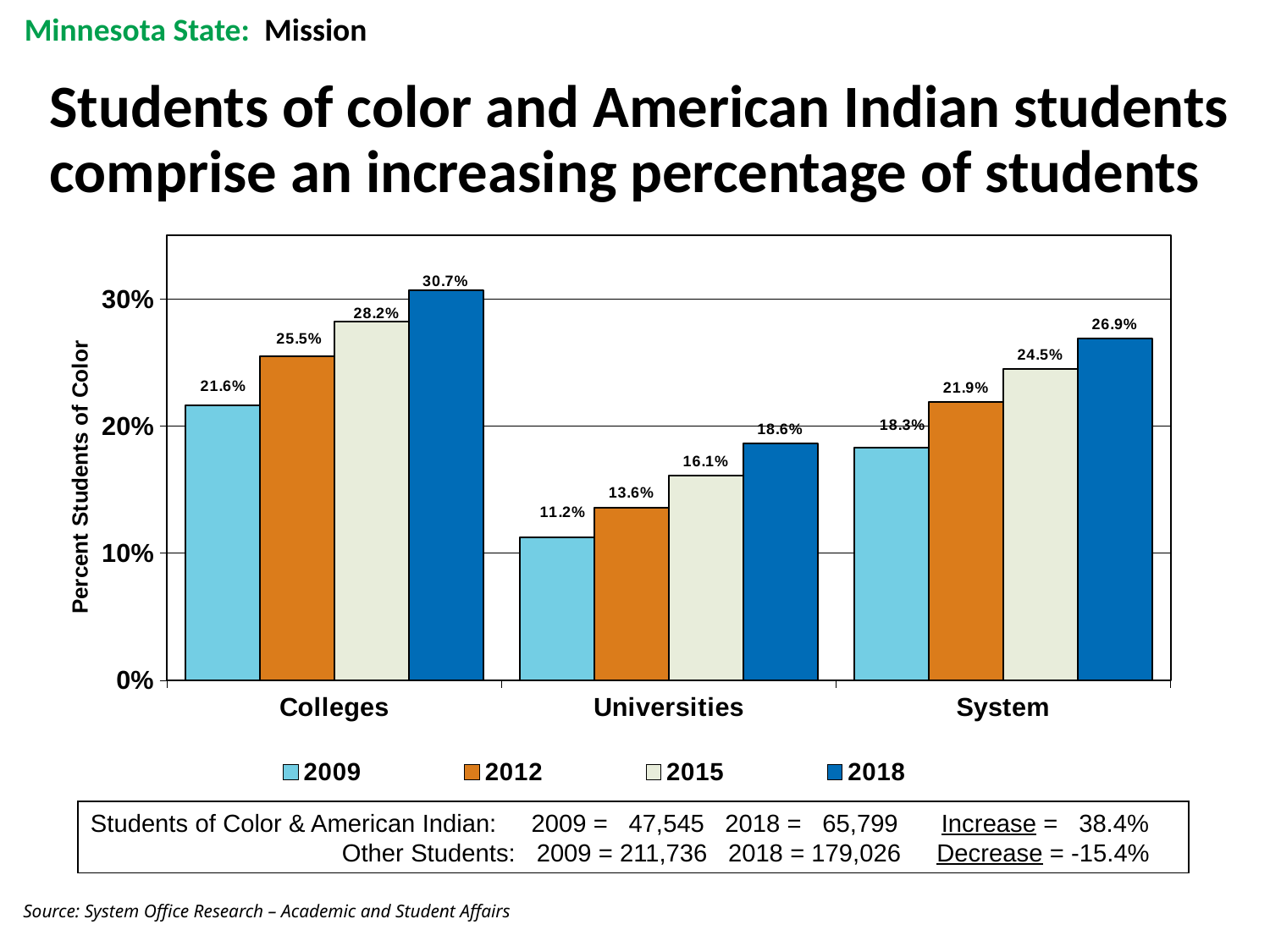
Is the value for Universities in 2018 greater or less than 20%? less Which category has the lowest value in 2012? Universities How many categories are shown on the x axis? 3 What kind of chart is shown? bar chart What is the value for Colleges in 2018? 30.7% Which is larger: the 2015 value for Universities or the 2009 value for System? 2009 value for System Do the values for System rise or fall from 2009 to 2018? rise What is the value for Universities in 2009? 11.2% Which category has the highest value in 2018? Colleges How many series does the legend list? 4 What is the difference between the 2018 and 2009 values for Colleges? 9.1% What is the value for System in 2015? 24.5%